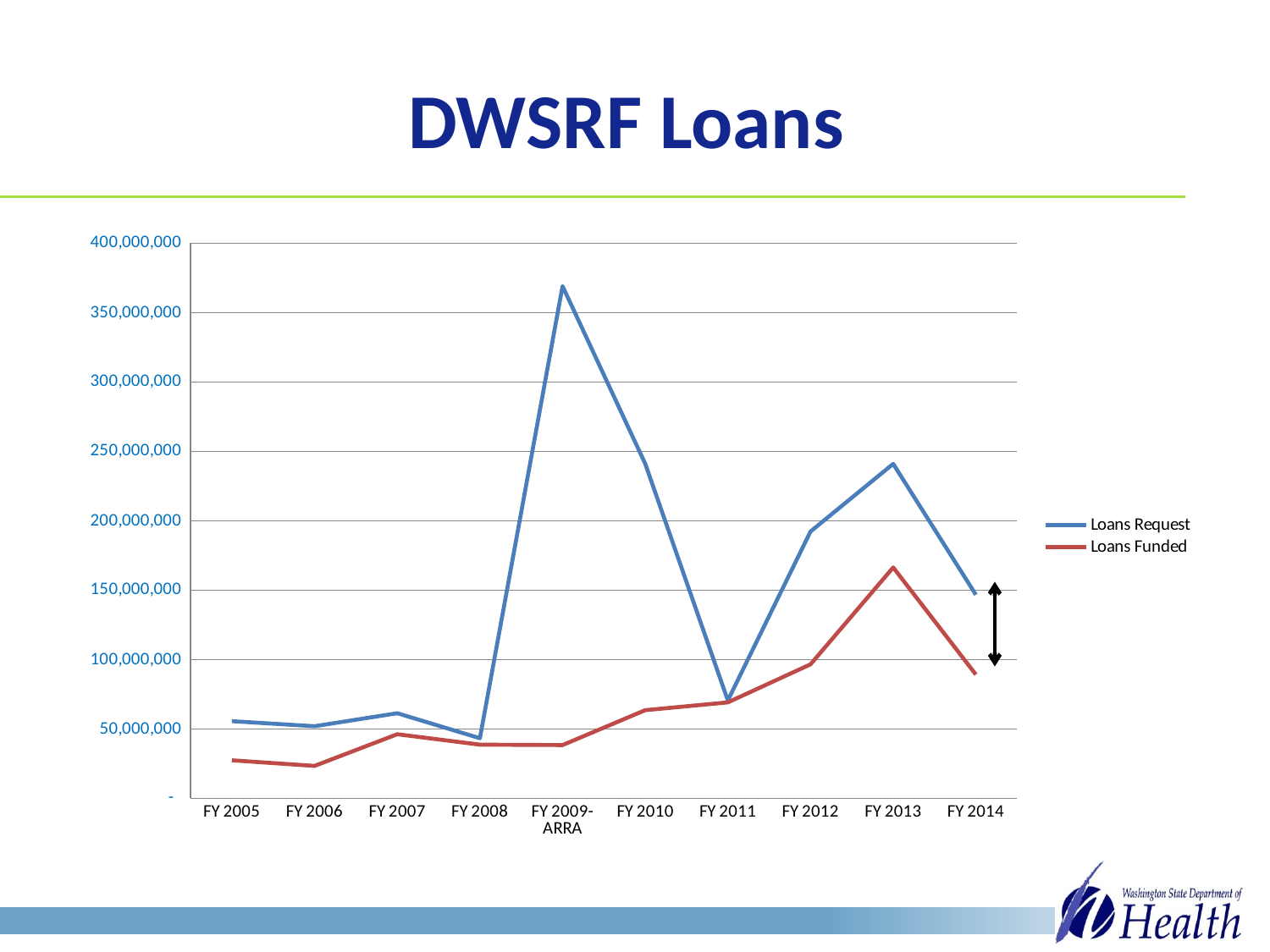
In which fiscal year is the Loans Request value highest? FY 2009-ARRA How many fiscal years are plotted along the x axis? 10 What is the title of the chart? DWSRF Loans In which fiscal year is the Loans Funded value highest? FY 2013 What kind of chart is shown on the slide? line chart Does the Loans Funded line rise or fall from FY 2010 to FY 2013? rise In FY 2012, which is larger: Loans Request or Loans Funded? Loans Request Is the Loans Request value for FY 2009-ARRA greater or less than 350,000,000? greater Is the Loans Request value for FY 2011 greater or less than 100,000,000? less Is the Loans Funded value for FY 2014 greater or less than 100,000,000? less How many series does the legend list? 2